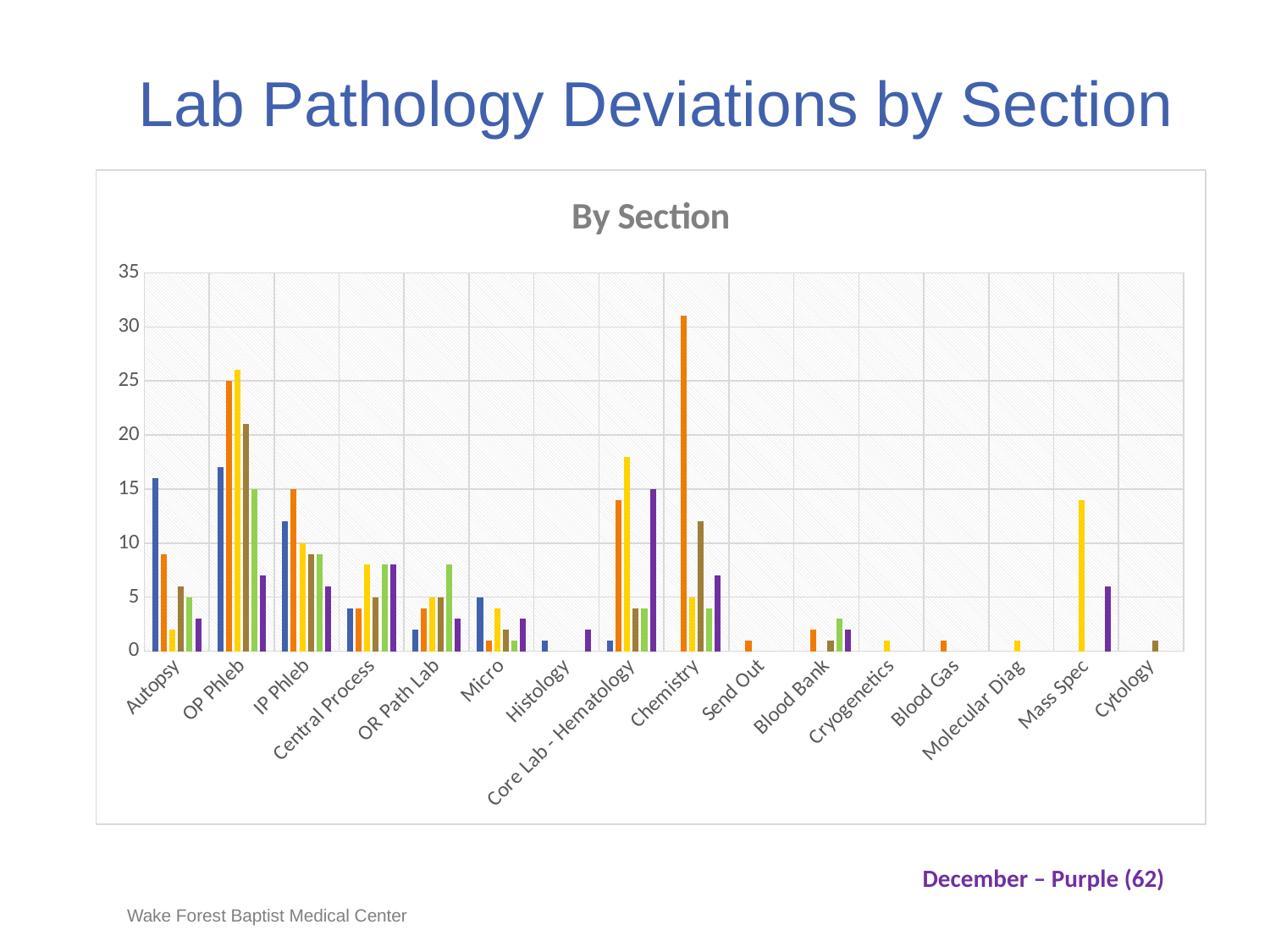
Is the purple bar for Histology greater or less than 5? less How many section categories are shown along the x axis? 16 Which section has the tallest purple bar? Core Lab - Hematology Is the tallest bar for Chemistry greater or less than 25? greater Which section has the tallest bar in the chart? Chemistry Is the yellow bar for Mass Spec greater or less than 10? greater Which has the taller orange bar, Chemistry or OP Phleb? Chemistry What kind of chart is shown on the slide? bar chart What is the title of the chart? By Section According to the slide, which colour represents December? Purple Which has the taller yellow bar, Core Lab - Hematology or Mass Spec? Core Lab - Hematology